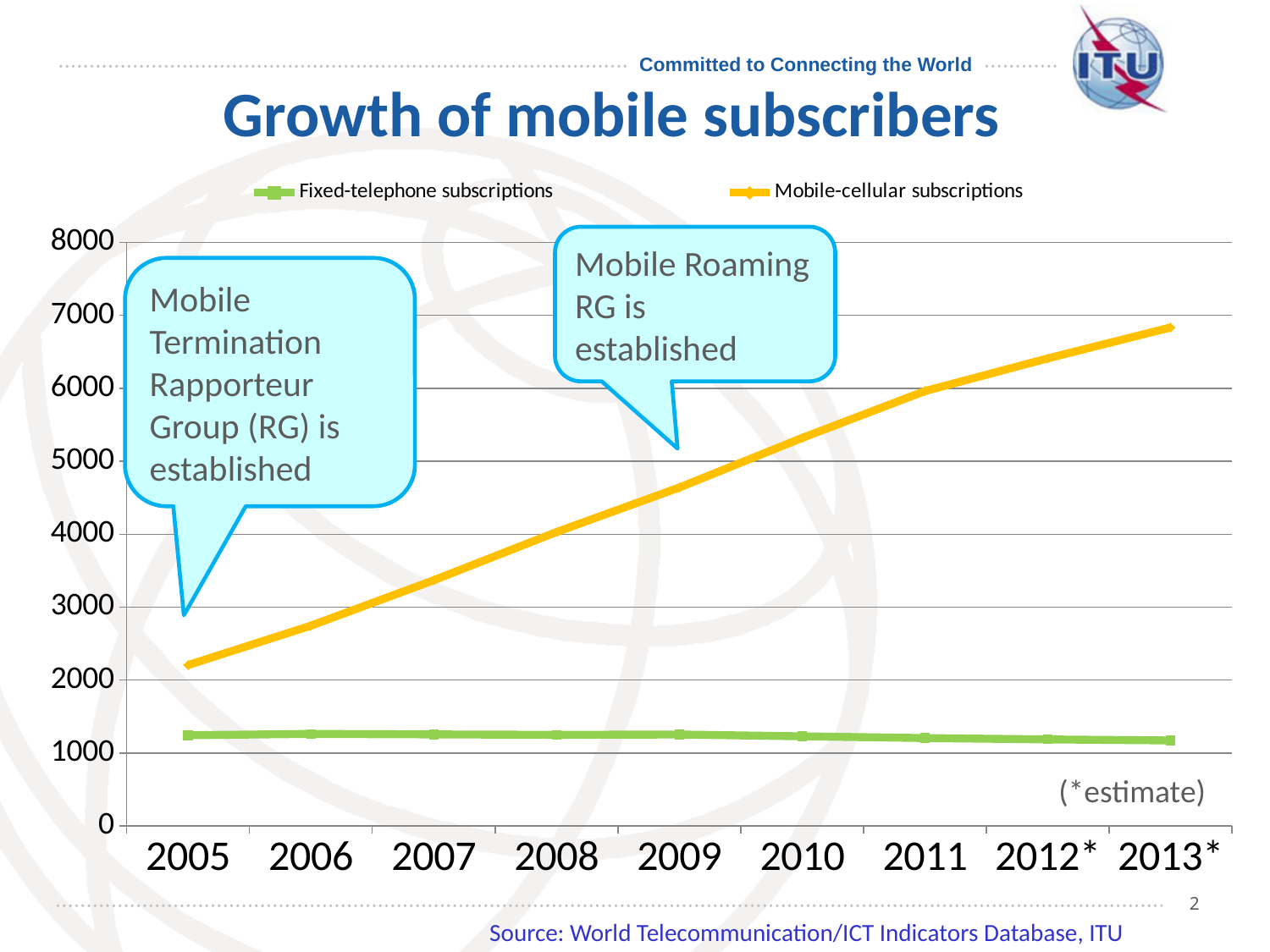
How many years are shown along the x axis? 9 Do the values for Mobile-cellular subscriptions rise or fall from 2005 to 2013*? Rise How many series does the legend list? 2 Which series has the larger value in 2010, Fixed-telephone subscriptions or Mobile-cellular subscriptions? Mobile-cellular subscriptions Is the value for Mobile-cellular subscriptions in 2009 greater or less than 4000? greater Which year has the highest value for Mobile-cellular subscriptions? 2013* Is the value for Mobile-cellular subscriptions in 2013* greater or less than 6000? greater What kind of chart is shown on the slide? Line chart Is the value for Mobile-cellular subscriptions in 2005 greater or less than 2000? greater Which year has the lowest value for Mobile-cellular subscriptions? 2005 What is the title of the chart? Growth of mobile subscribers